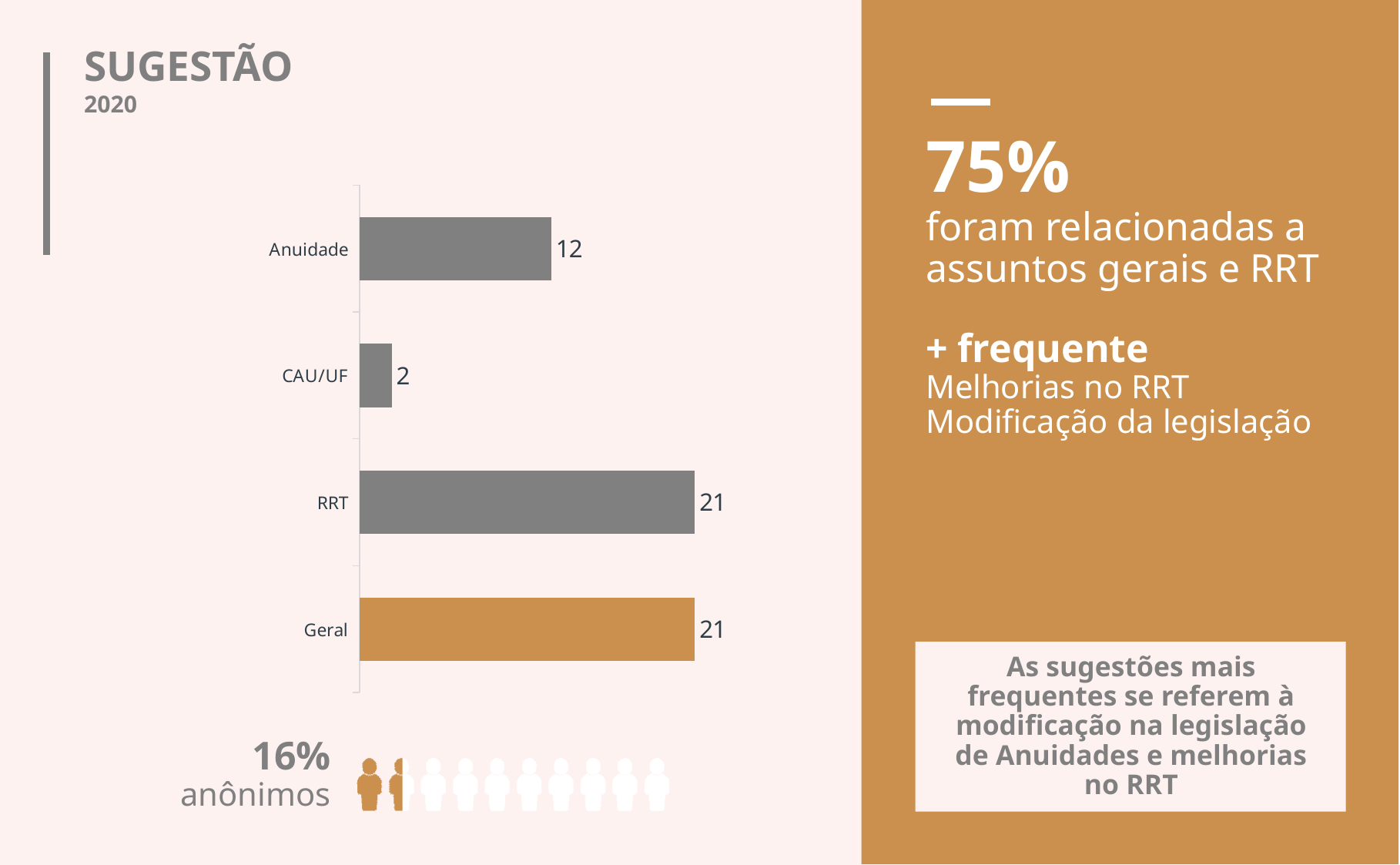
Which category has the lowest value? CAU/UF What is the difference between the values for Anuidade and CAU/UF? 10 What is the value for CAU/UF? 2 Which is larger, the value for Anuidade or the value for CAU/UF? Anuidade Which category's bar is coloured differently (orange) from the others? Geral What is the value for Geral? 21 Which is larger, the value for RRT or the value for Anuidade? RRT What is the value for RRT? 21 What is the value for Anuidade? 12 What kind of chart is shown on the slide? Bar chart How many categories are shown in the chart? 4 What is the difference between the values for RRT and Anuidade? 9